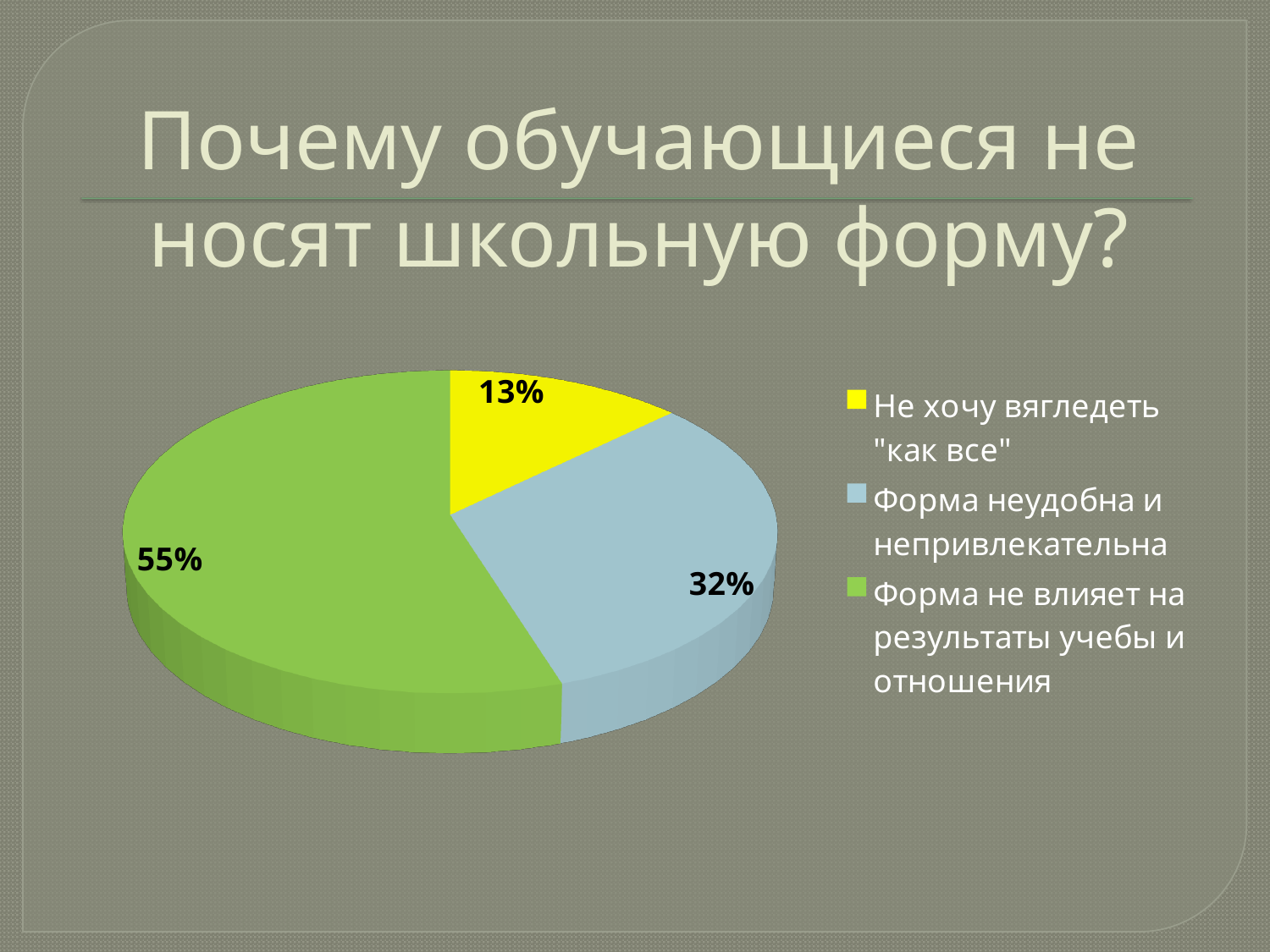
What is the title of the slide containing the chart? Почему обучающиеся не носят школьную форму? Which category has the smallest share of the pie? Не хочу вягледеть "как все" How many categories does the pie chart have? 3 What percentage is shown for "Не хочу вягледеть "как все""? 13% What is the difference in percentage points between "Форма неудобна и непривлекательна" and "Не хочу вягледеть "как все""? 19 What is the difference in percentage points between "Форма не влияет на результаты учебы и отношения" and "Форма неудобна и непривлекательна"? 23 Which category has the largest share of the pie? Форма не влияет на результаты учебы и отношения What type of chart is shown on the slide? Pie chart What percentage is shown for "Форма не влияет на результаты учебы и отношения"? 55% Which is larger: the share for "Форма неудобна и непривлекательна" or the share for "Не хочу вягледеть "как все""? Форма неудобна и непривлекательна What percentage is shown for "Форма неудобна и непривлекательна"? 32% What colour is the slice for "Не хочу вягледеть "как все""? Yellow